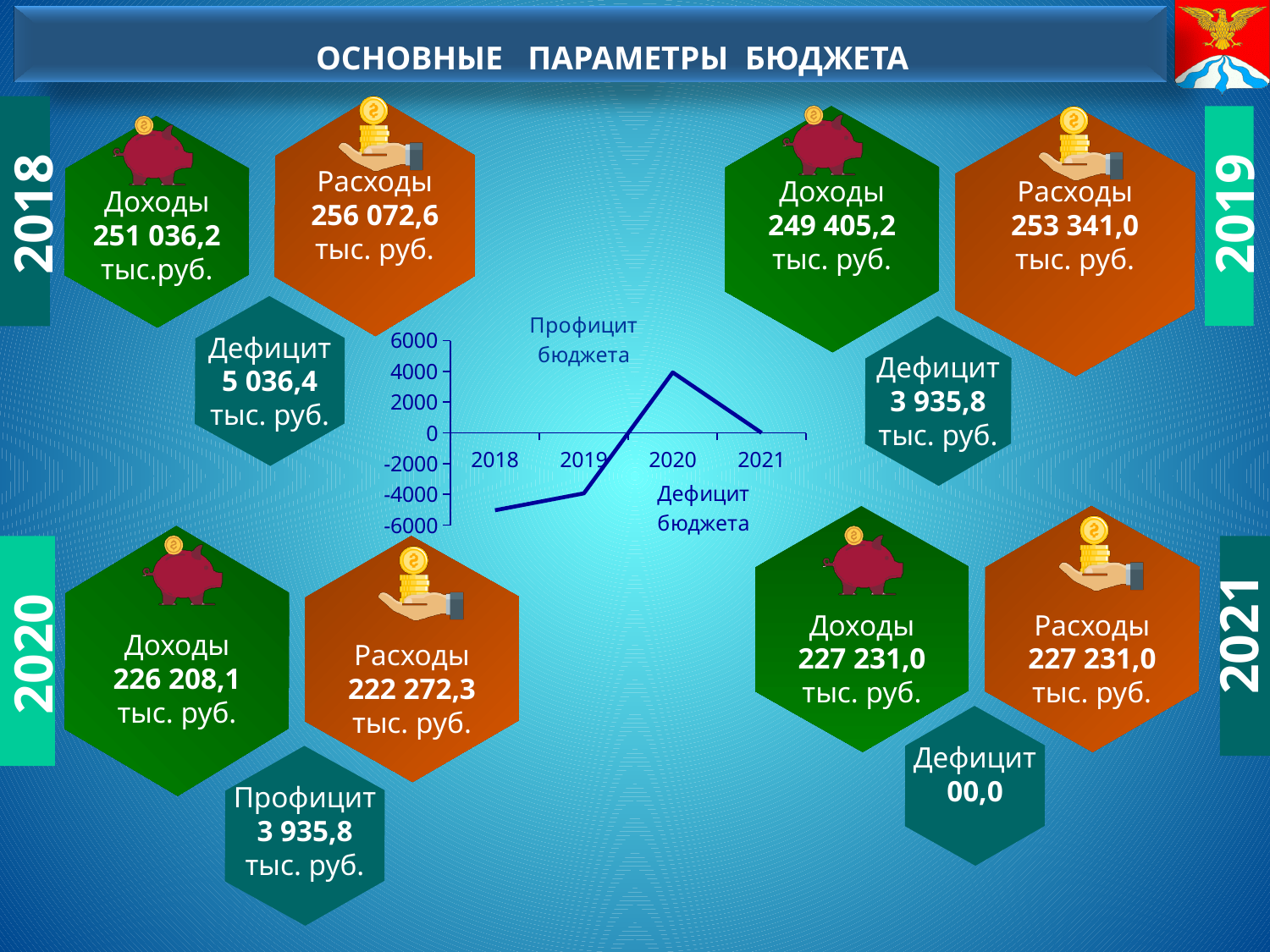
What kind of chart is shown in the centre of the slide? line chart Which year has the highest value on the line chart? 2020 What label appears above the line chart near the top of the y axis? Профицит бюджета On the line chart, which year has the larger value, 2019 or 2020? 2020 Which year has the lowest value on the line chart? 2018 Is the value for 2020 on the line chart greater or less than 2000? greater Is the value for 2019 on the line chart greater or less than -6000? greater Does the line rise or fall from 2018 to 2020? rises Is the value for 2018 on the line chart greater or less than -4000? less Does the line rise or fall from 2020 to 2021? falls How many years are plotted along the x axis of the line chart? 4